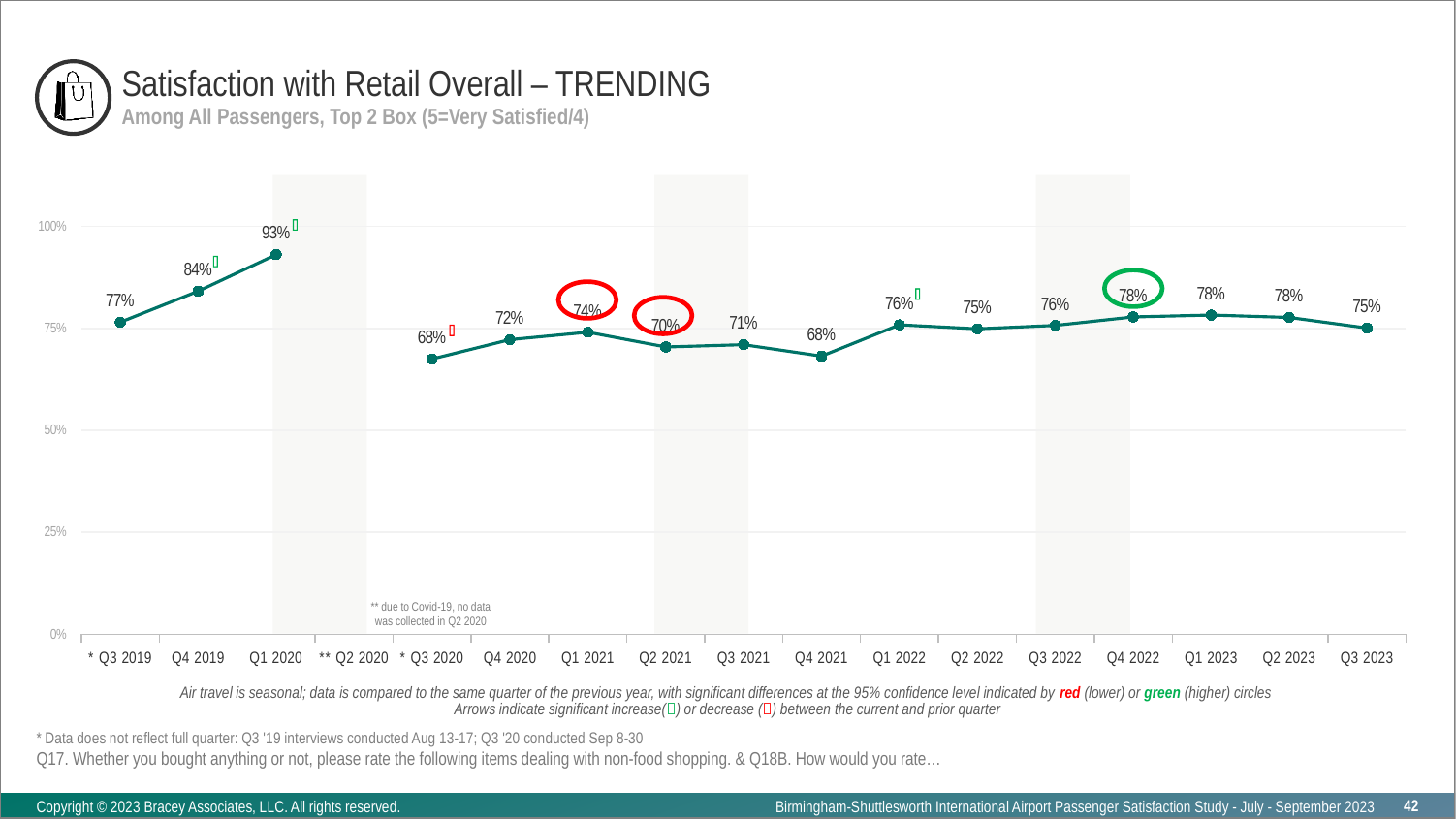
What is the satisfaction value for Q1 2020? 93% How many quarters have a plotted data point on the chart? 16 What is the lowest satisfaction value plotted on the chart? 68% Which quarter on the x axis has no data plotted? Q2 2020 Do the values rise or fall from Q3 2019 to Q1 2020? Rise What is the difference between the values for Q1 2020 and Q3 2019? 16 percentage points Which is larger, the value for Q4 2019 or the value for Q1 2022? Q4 2019 What type of chart is shown on the slide? Line chart What is the satisfaction value for Q4 2021? 68% Which quarter has the highest satisfaction value? Q1 2020 What is the satisfaction value for Q3 2023? 75% What is the difference between the values for Q2 2023 and Q3 2023? 3 percentage points